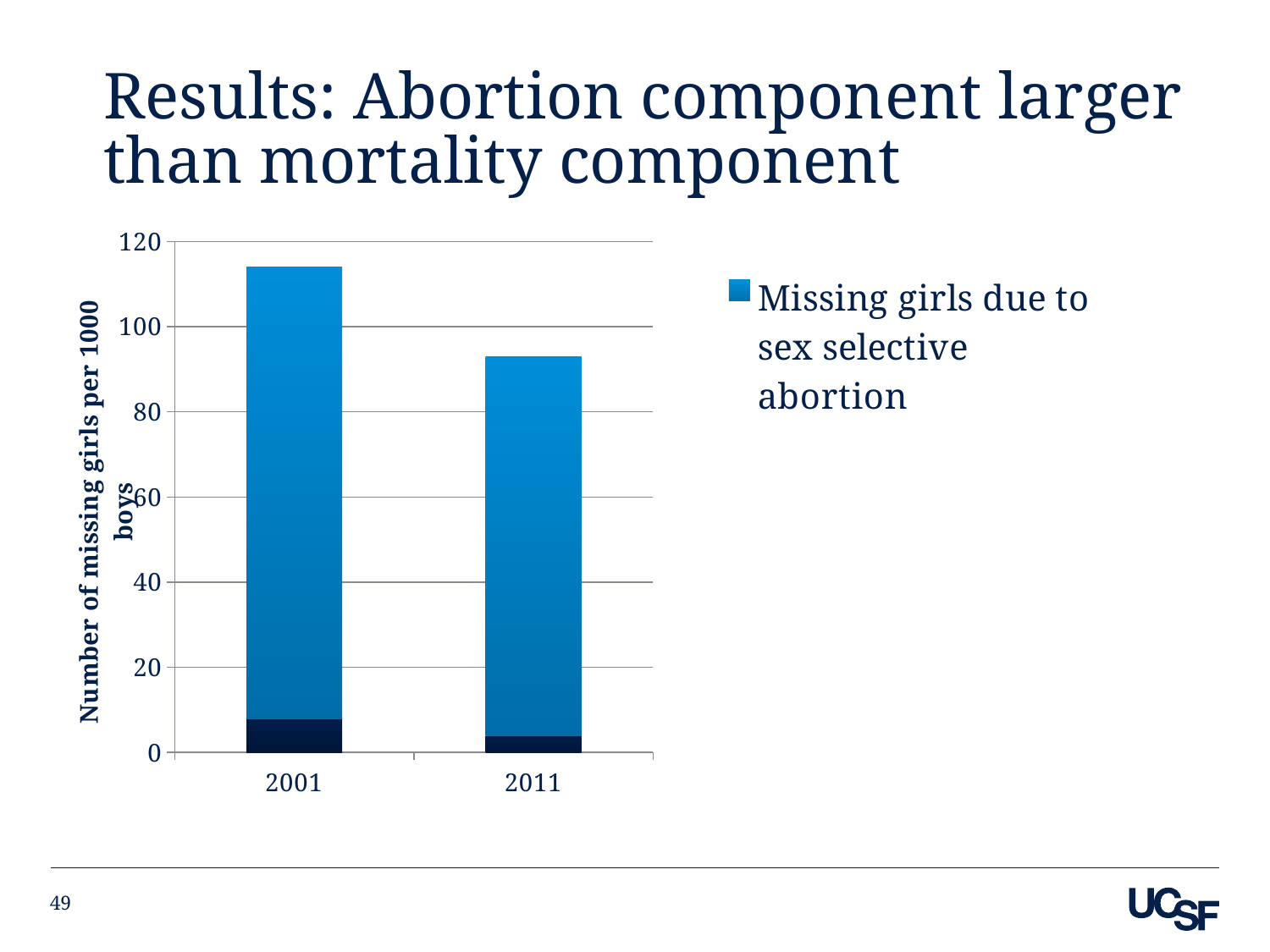
Which year has the highest total number of missing girls per 1000 boys? 2001 What is the title of the chart's vertical axis? Number of missing girls per 1000 boys How many categories are shown on the x axis of the chart? 2 Which year has the taller stacked bar, 2001 or 2011? 2001 Is the total value for 2001 greater or less than 100? greater Is the total value for 2011 greater or less than 80? greater How many series does the chart's legend list? 1 Which year has the lowest total number of missing girls per 1000 boys? 2011 What series name is listed in the chart's legend? Missing girls due to sex selective abortion What kind of chart is shown on the slide? bar chart Do the total values rise or fall from 2001 to 2011? fall Is the total value for 2011 greater or less than 100? less